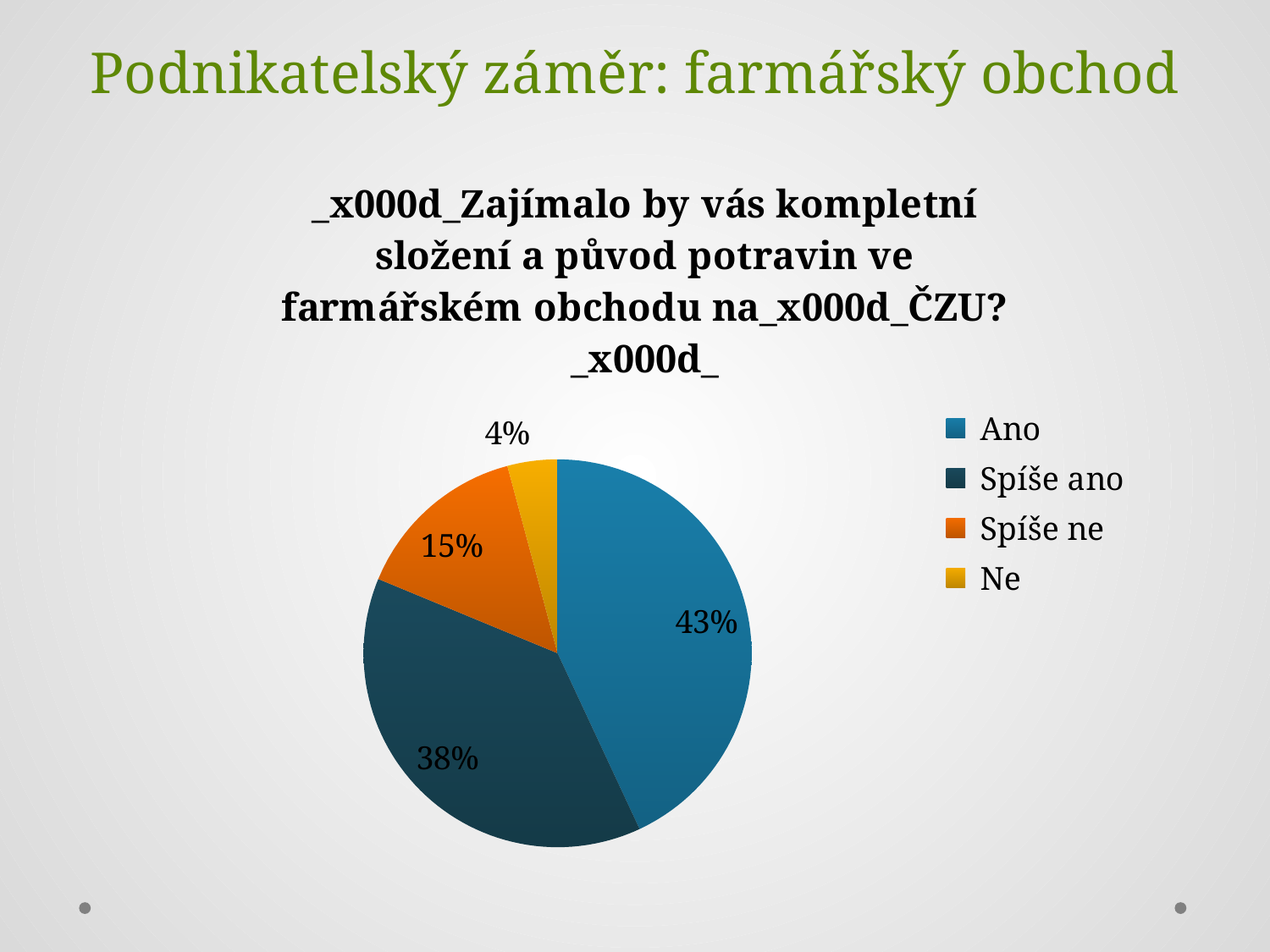
Which answer has the smallest share of the pie? Ne Which is larger, the share for "Spíše ne" or the share for "Ne"? Spíše ne Which answer has the largest share of the pie? Ano What percentage of respondents answered "Spíše ne"? 15% How many categories does the legend list? 4 What percentage of respondents answered "Ano"? 43% What is the difference in percentage points between "Spíše ne" and "Ne"? 11 What kind of chart is shown on the slide? pie chart What percentage of respondents answered "Ne"? 4% What is the difference in percentage points between "Ano" and "Spíše ano"? 5 What colour is the slice for "Ne"? yellow What percentage of respondents answered "Spíše ano"? 38%